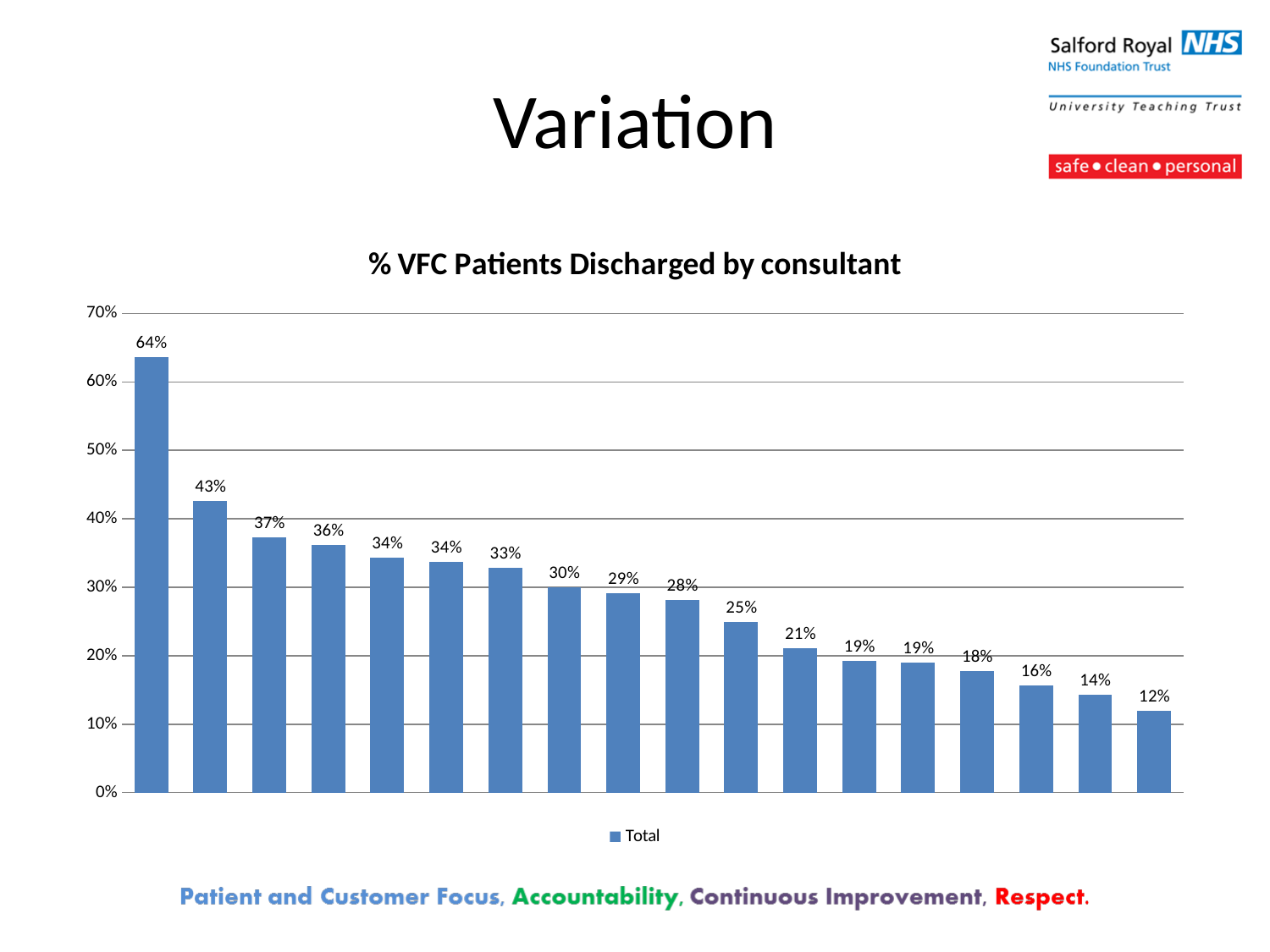
How many series does the legend list? 1 What is the highest value shown in the chart? 64% What is the title of the chart? % VFC Patients Discharged by consultant What is the name of the series shown in the legend? Total What is the difference between the first and second bars from the left? 21 percentage points How many bars have a value of exactly 34%? 2 What kind of chart is shown on the slide? Bar chart Do the values rise or fall from left to right along the x axis? Fall What is the lowest value shown in the chart? 12% What is the value of the second bar from the left? 43% What is the difference between the highest and lowest values in the chart? 52 percentage points How many bars are plotted in the chart? 18